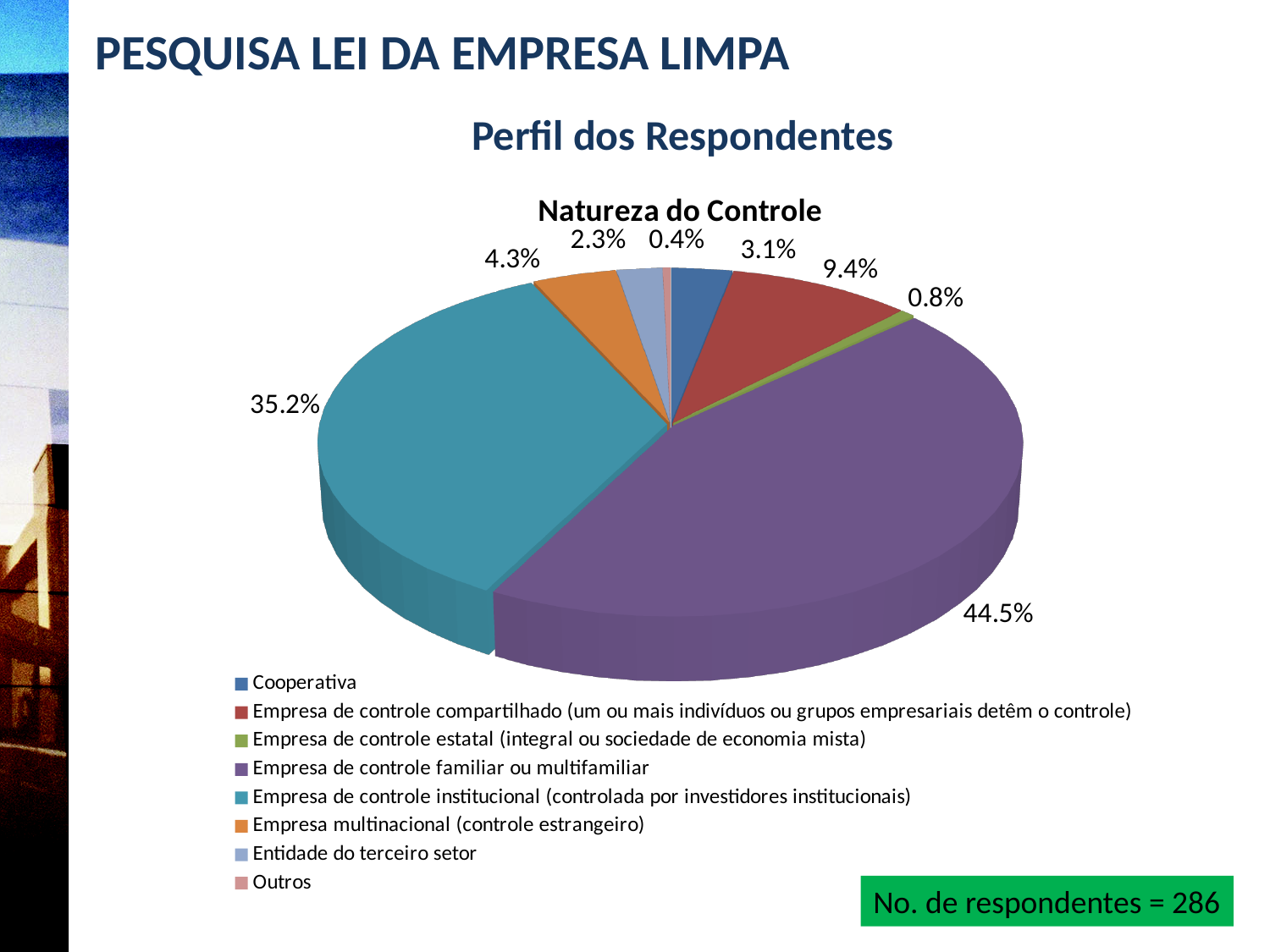
What is the difference in percentage points between 'Empresa de controle familiar ou multifamiliar' and 'Empresa de controle institucional'? 9.3 What percentage of respondents are 'Cooperativa'? 3.1% What is the share of 'Empresa de controle estatal (integral ou sociedade de economia mista)'? 0.8% What percentage of respondents are 'Empresa de controle familiar ou multifamiliar'? 44.5% Which category has the smallest share of the pie? Outros What is the title of the chart? Natureza do Controle Which is larger: the share for 'Empresa de controle compartilhado' or the share for 'Empresa multinacional'? Empresa de controle compartilhado What type of chart is shown on the slide? pie chart What percentage of respondents are 'Empresa multinacional (controle estrangeiro)'? 4.3% What percentage of respondents are 'Empresa de controle institucional (controlada por investidores institucionais)'? 35.2% How many categories does the legend list? 8 Which category has the largest share of the pie? Empresa de controle familiar ou multifamiliar